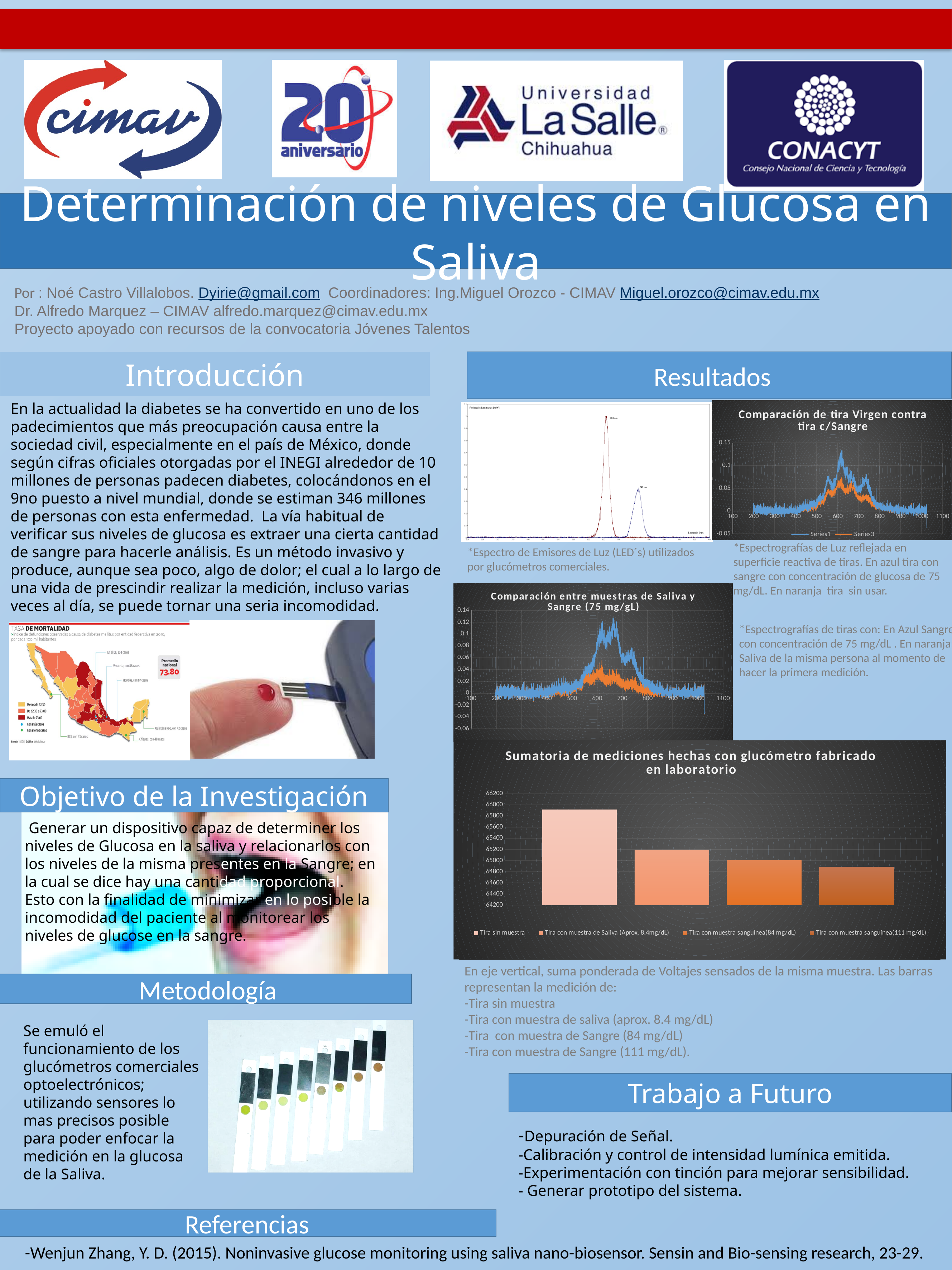
In the chart "Sumatoria de mediciones hechas con glucómetro fabricado en laboratorio", is the value for Tira con muestra sanguínea(111 mg/dL) greater or less than 65200? less In the chart "Sumatoria de mediciones hechas con glucómetro fabricado en laboratorio", is the value for Tira con muestra de Saliva (Aprox. 8.4mg/dL) greater or less than 65400? less In the chart "Sumatoria de mediciones hechas con glucómetro fabricado en laboratorio", which category has the highest value? Tira sin muestra What are the legend entries of the chart "Comparación de tira Virgen contra tira c/Sangre"? Series1 and Series3 In the chart "Sumatoria de mediciones hechas con glucómetro fabricado en laboratorio", do the bar values rise or fall from left to right? fall In the chart "Sumatoria de mediciones hechas con glucómetro fabricado en laboratorio", is the value for Tira sin muestra greater or less than 65600? greater In the chart "Sumatoria de mediciones hechas con glucómetro fabricado en laboratorio", which is larger: Tira sin muestra or Tira con muestra de Saliva (Aprox. 8.4mg/dL)? Tira sin muestra What kind of chart is "Sumatoria de mediciones hechas con glucómetro fabricado en laboratorio"? bar chart In the chart "Sumatoria de mediciones hechas con glucómetro fabricado en laboratorio", how many bars are plotted? 4 What kind of chart is "Comparación de tira Virgen contra tira c/Sangre"? line chart How many series does the legend of the chart "Comparación de tira Virgen contra tira c/Sangre" list? 2